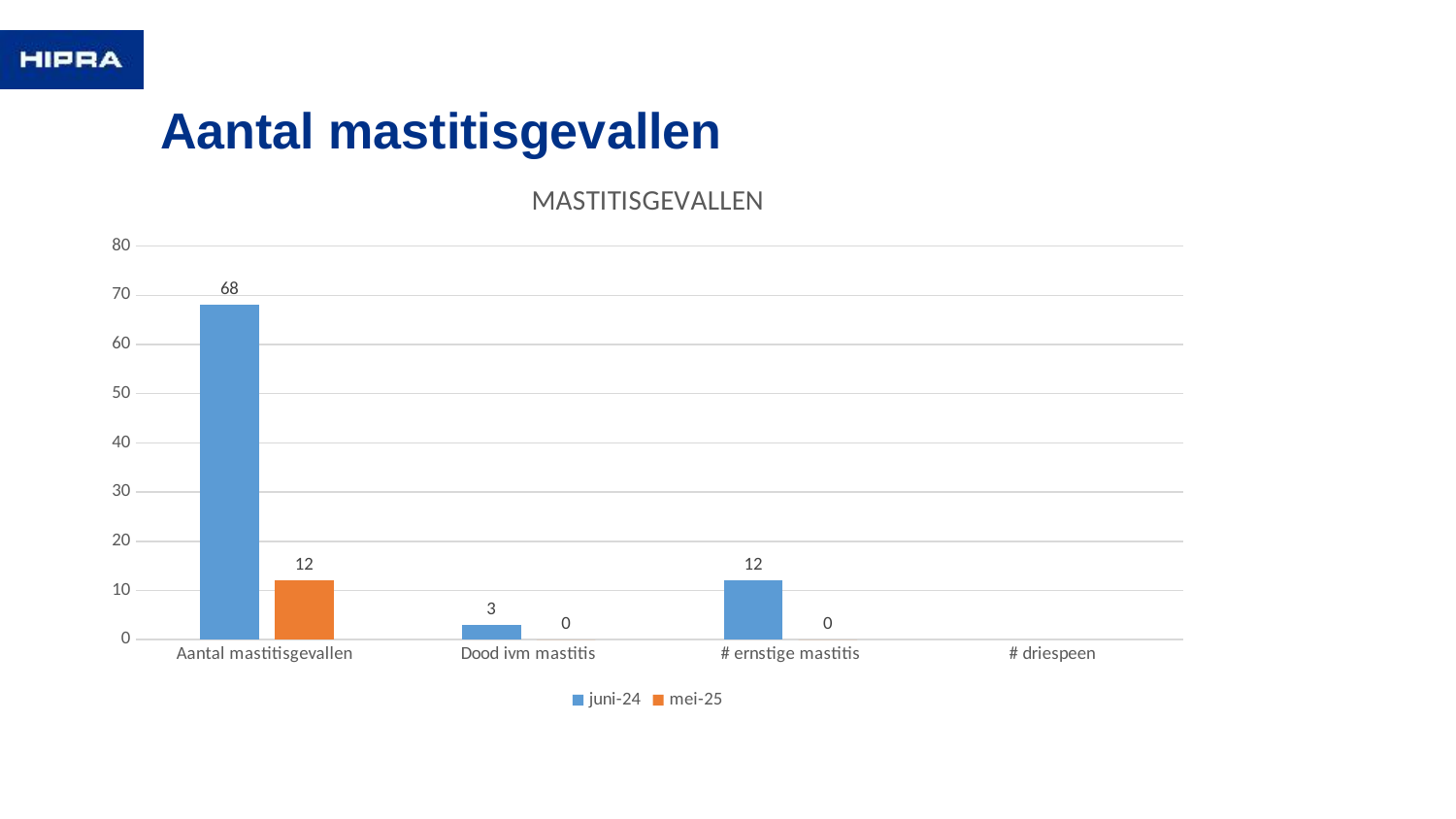
What is the mei-25 value for Aantal mastitisgevallen? 12 Is the juni-24 value for Aantal mastitisgevallen greater or less than 60? greater What is the difference between the juni-24 and mei-25 values for Aantal mastitisgevallen? 56 What is the juni-24 value for Aantal mastitisgevallen? 68 Which is larger for Dood ivm mastitis: the juni-24 value or the mei-25 value? juni-24 What kind of chart is shown on the slide? bar chart What is the mei-25 value for # ernstige mastitis? 0 Which category has the highest juni-24 value? Aantal mastitisgevallen What is the juni-24 value for # ernstige mastitis? 12 How many series does the legend list? 2 What is the juni-24 value for Dood ivm mastitis? 3 What is the title of the chart? MASTITISGEVALLEN